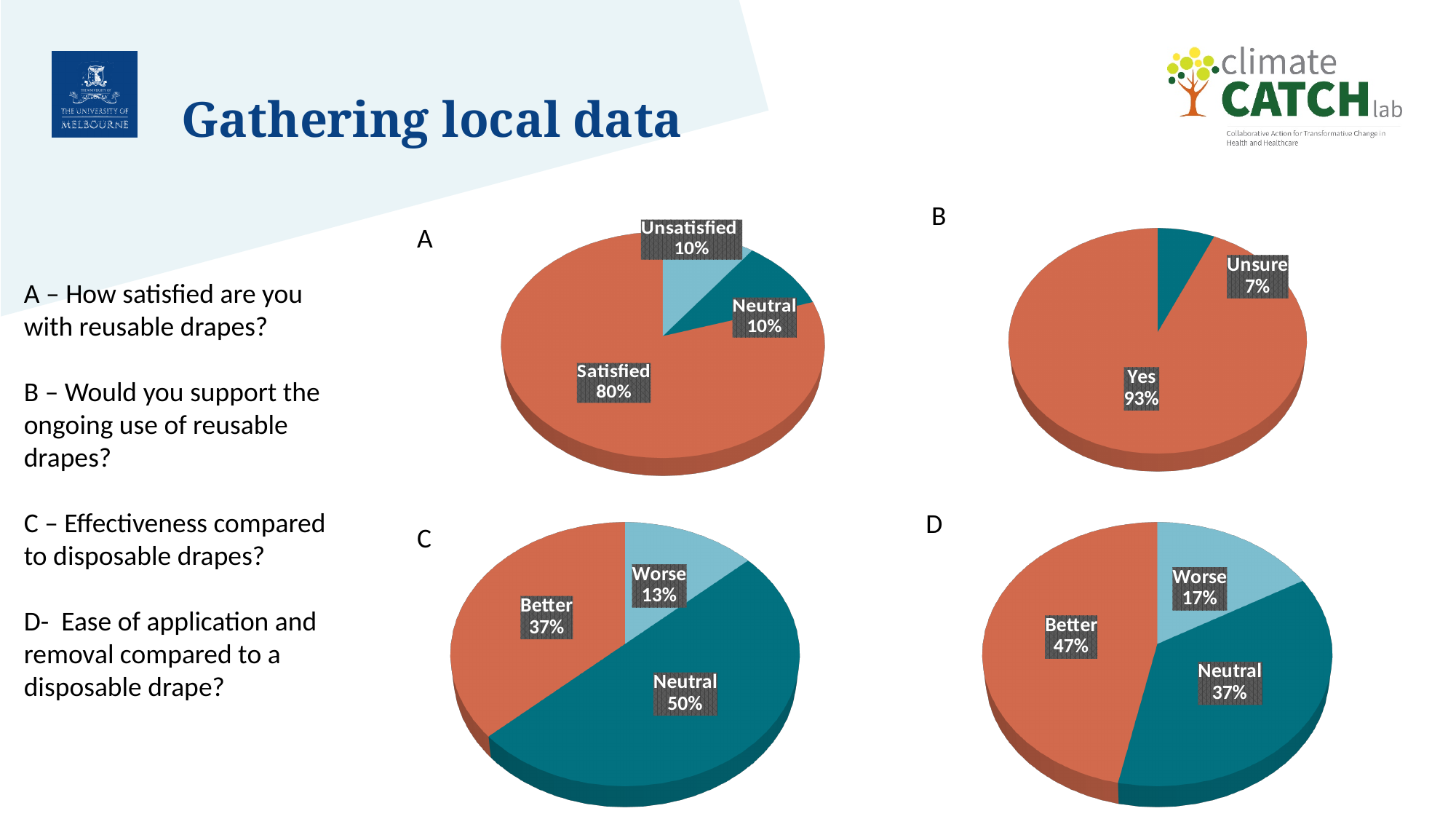
In chart B, what percentage of respondents answered Yes to supporting ongoing use of reusable drapes? 93% In chart A, what is the difference in percentage points between Satisfied and Neutral? 70 In chart C, which category has the smallest share? Worse What type of chart is chart A? Pie chart In chart C, what percentage rated effectiveness as Neutral? 50% How many slices does chart B have? 2 In chart C, which is larger, Better or Neutral? Neutral In chart D, which category has the largest share? Better In chart B, what is the share of the Unsure slice? 7% In chart A, what percentage of respondents are Satisfied with reusable drapes? 80% In chart D, what is the difference in percentage points between Better and Neutral? 10 In chart D, what percentage rated ease of application and removal as Worse? 17%